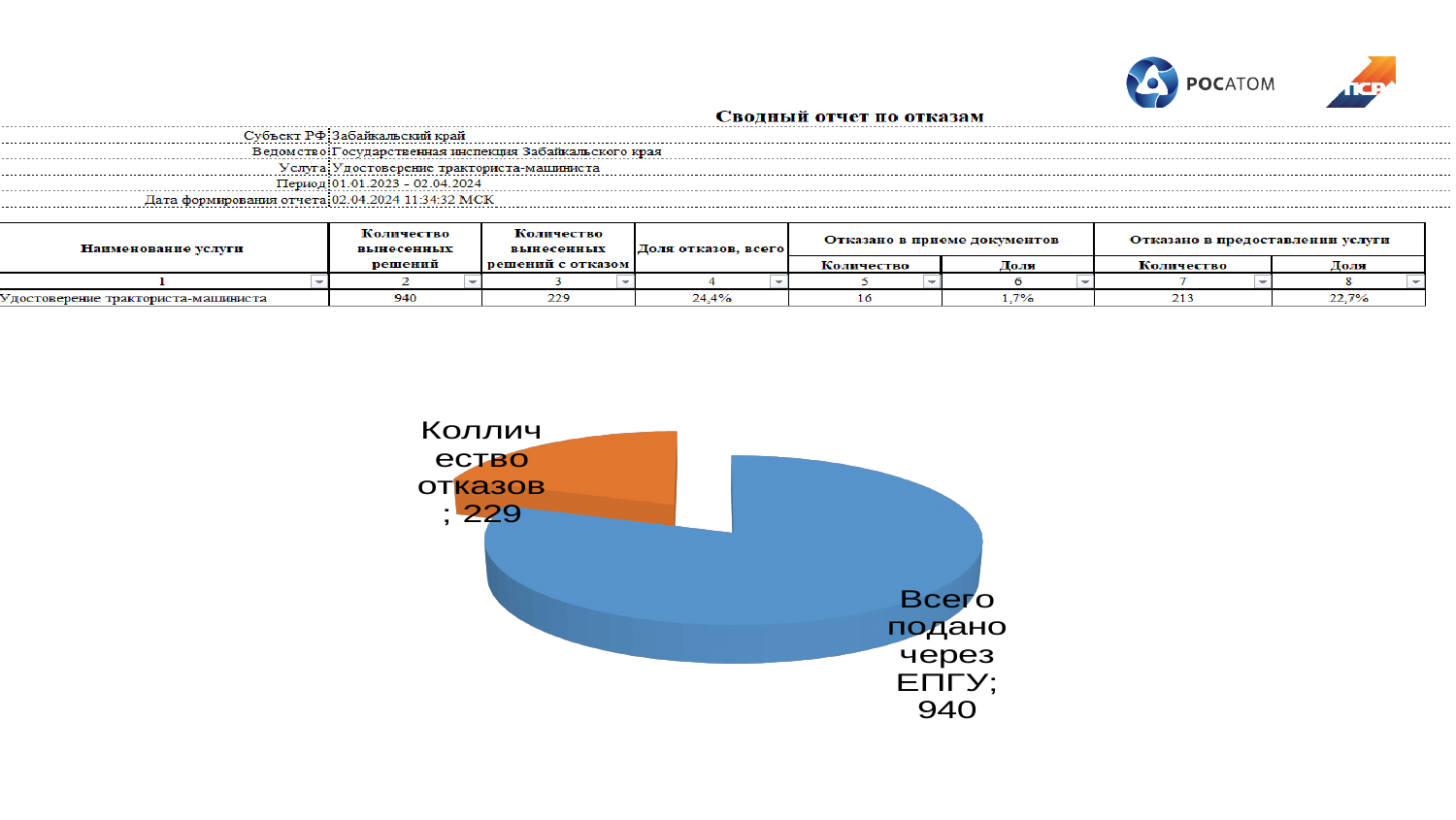
What is the difference between the "Всего подано через ЕПГУ" value and the "Колличество отказов" value in the pie chart? 711 What colour is the "Колличество отказов" slice of the pie chart? Orange What value is shown for the "Всего подано через ЕПГУ" slice of the pie chart? 940 What is the sum of the two values shown in the pie chart? 1169 Which slice of the pie chart has the largest value? Всего подано через ЕПГУ What kind of chart is shown on the slide? Pie chart Which slice of the pie chart has the smallest value? Колличество отказов What colour is the "Всего подано через ЕПГУ" slice of the pie chart? Blue What value is shown for the "Колличество отказов" slice of the pie chart? 229 Which is larger in the pie chart: "Всего подано через ЕПГУ" or "Колличество отказов"? Всего подано через ЕПГУ How many slices does the pie chart have? 2